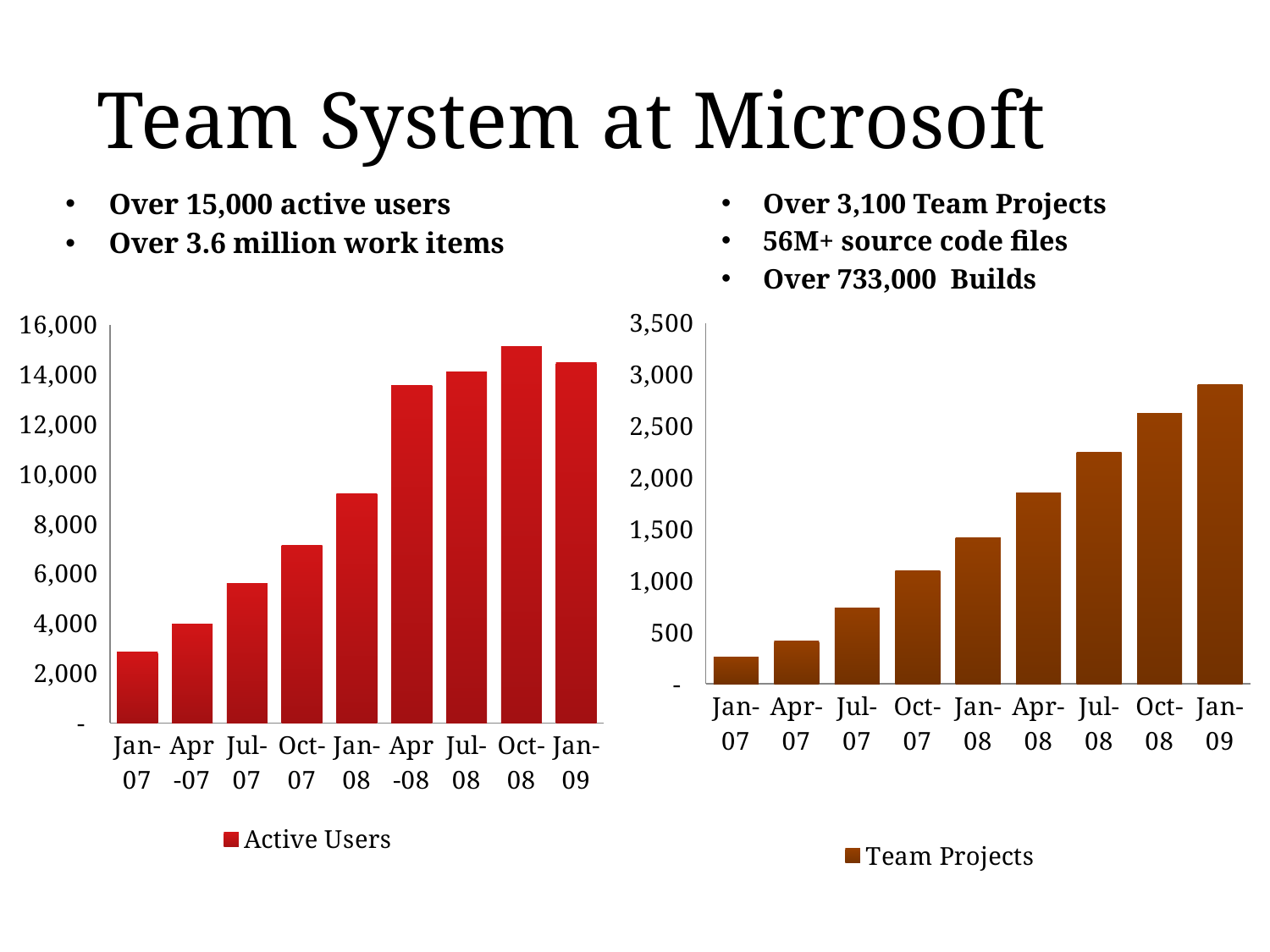
In the Team Projects chart on the right, is the value for Jul-07 greater or less than 1,000? less What kind of chart is the Active Users chart on the left? bar chart In the Team Projects chart on the right, which period has the highest value? Jan-09 In the Active Users chart on the left, is the value for Jan-08 greater or less than 8,000? greater In the Active Users chart on the left, which period has the highest value? Oct-08 In the Team Projects chart on the right, do the values generally rise or fall from Jan-07 to Jan-09? rise What is the legend entry of the chart on the right? Team Projects How many series does the legend of the Active Users chart list? 1 In the Active Users chart on the left, which period has the lowest value? Jan-07 In the Team Projects chart on the right, which period has the lowest value? Jan-07 How many time periods are shown on the x axis of the Team Projects chart on the right? 9 In the Active Users chart on the left, which is larger, the value for Apr-08 or the value for Jan-08? Apr-08